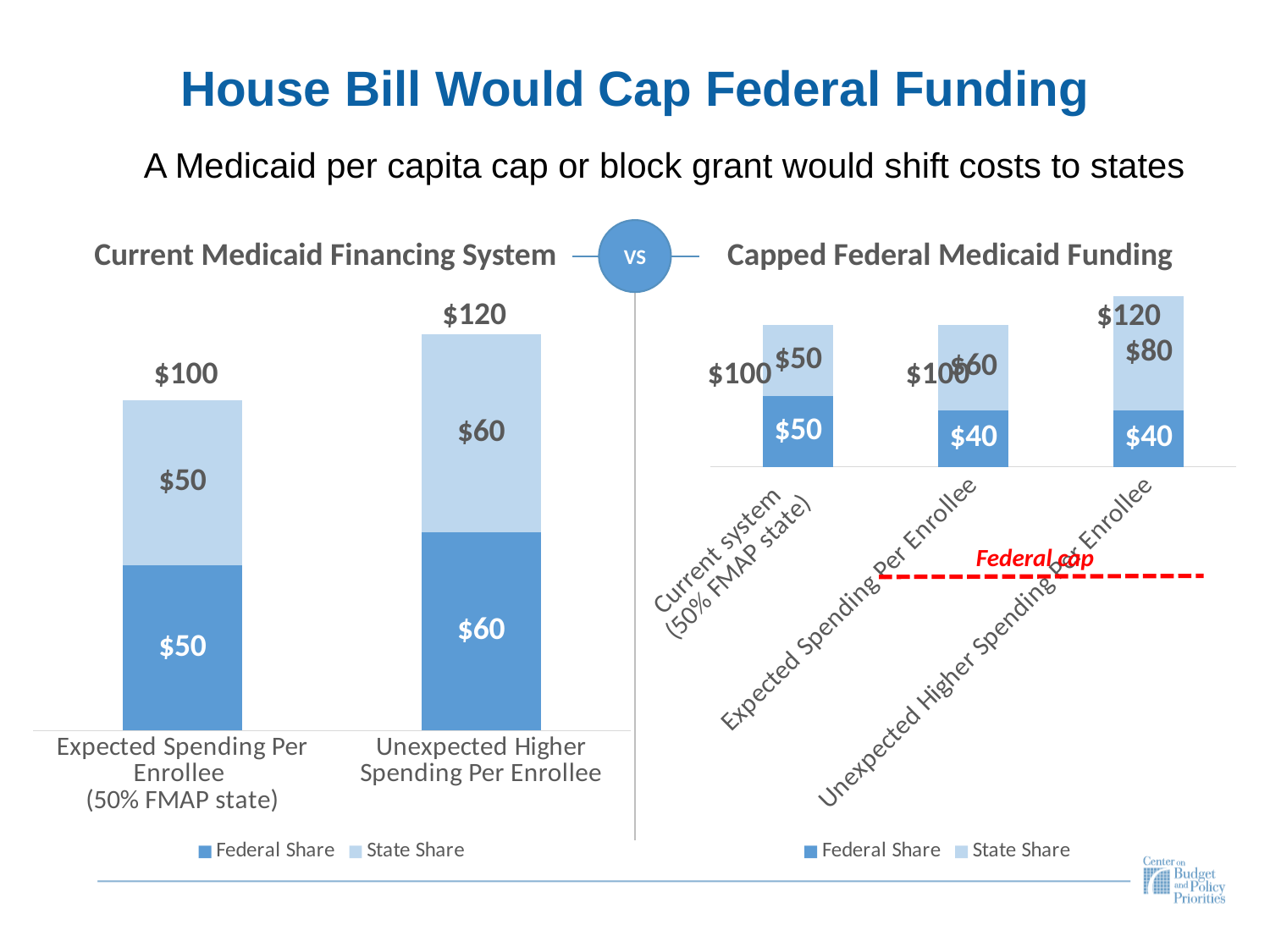
In the Capped Federal Medicaid Funding chart, which category has the highest total bar? Unexpected Higher Spending Per Enrollee In the Capped Federal Medicaid Funding chart, what is the State Share for Expected Spending Per Enrollee? $60 In the Current Medicaid Financing System chart, what is the State Share for Unexpected Higher Spending Per Enrollee? $60 In the Capped Federal Medicaid Funding chart, what is the Federal Share for Unexpected Higher Spending Per Enrollee? $40 How many series does the legend of the Current Medicaid Financing System chart list? 2 In the Current Medicaid Financing System chart, what is the Federal Share for Expected Spending Per Enrollee (50% FMAP state)? $50 In the Capped Federal Medicaid Funding chart, what is the difference between the State Share and the Federal Share for Unexpected Higher Spending Per Enrollee? $40 What type of chart is the Capped Federal Medicaid Funding chart? Stacked bar chart In the Capped Federal Medicaid Funding chart, how many categories are shown on the x axis? 3 In the Capped Federal Medicaid Funding chart, what is the State Share for Unexpected Higher Spending Per Enrollee? $80 In the Current Medicaid Financing System chart, what is the total of the Unexpected Higher Spending Per Enrollee bar? $120 In the Current Medicaid Financing System chart, how many categories are shown on the x axis? 2